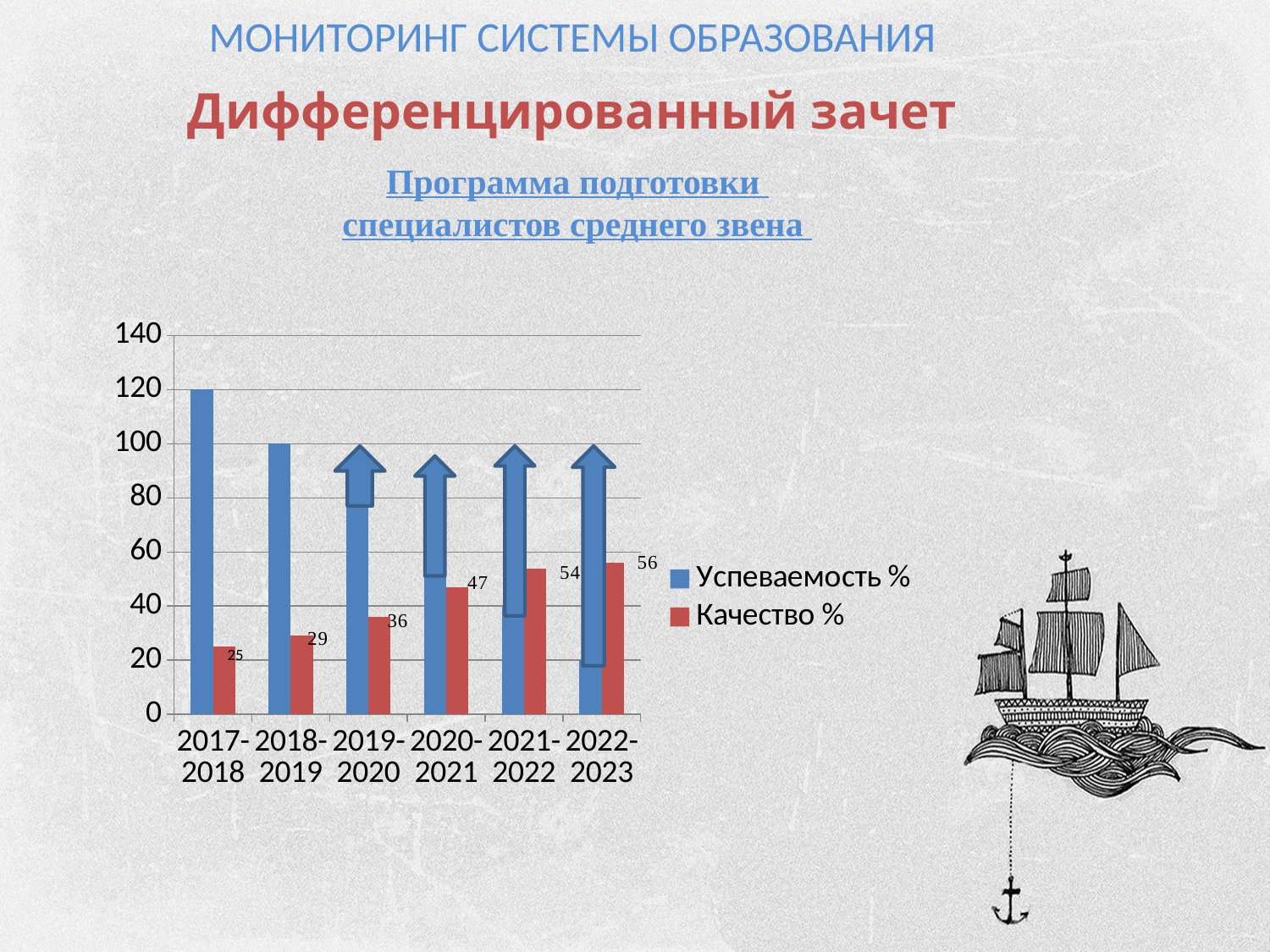
How many series does the legend list? 2 Which is larger, Качество % in 2019-2020 or in 2021-2022? 2021-2022 How many academic years are shown on the x axis? 6 What is the value of Качество % for 2020-2021? 47 Which academic year has the highest Качество %? 2022-2023 What is the value of Качество % for 2022-2023? 56 Does Качество % rise or fall from 2017-2018 to 2022-2023? rises Is the value of Успеваемость % for 2018-2019 greater or less than 80? greater Which academic year has the lowest Качество %? 2017-2018 What is the value of Успеваемость % for 2017-2018? 120 What is the value of Качество % for 2017-2018? 25 What is the difference between Качество % in 2022-2023 and in 2017-2018? 31